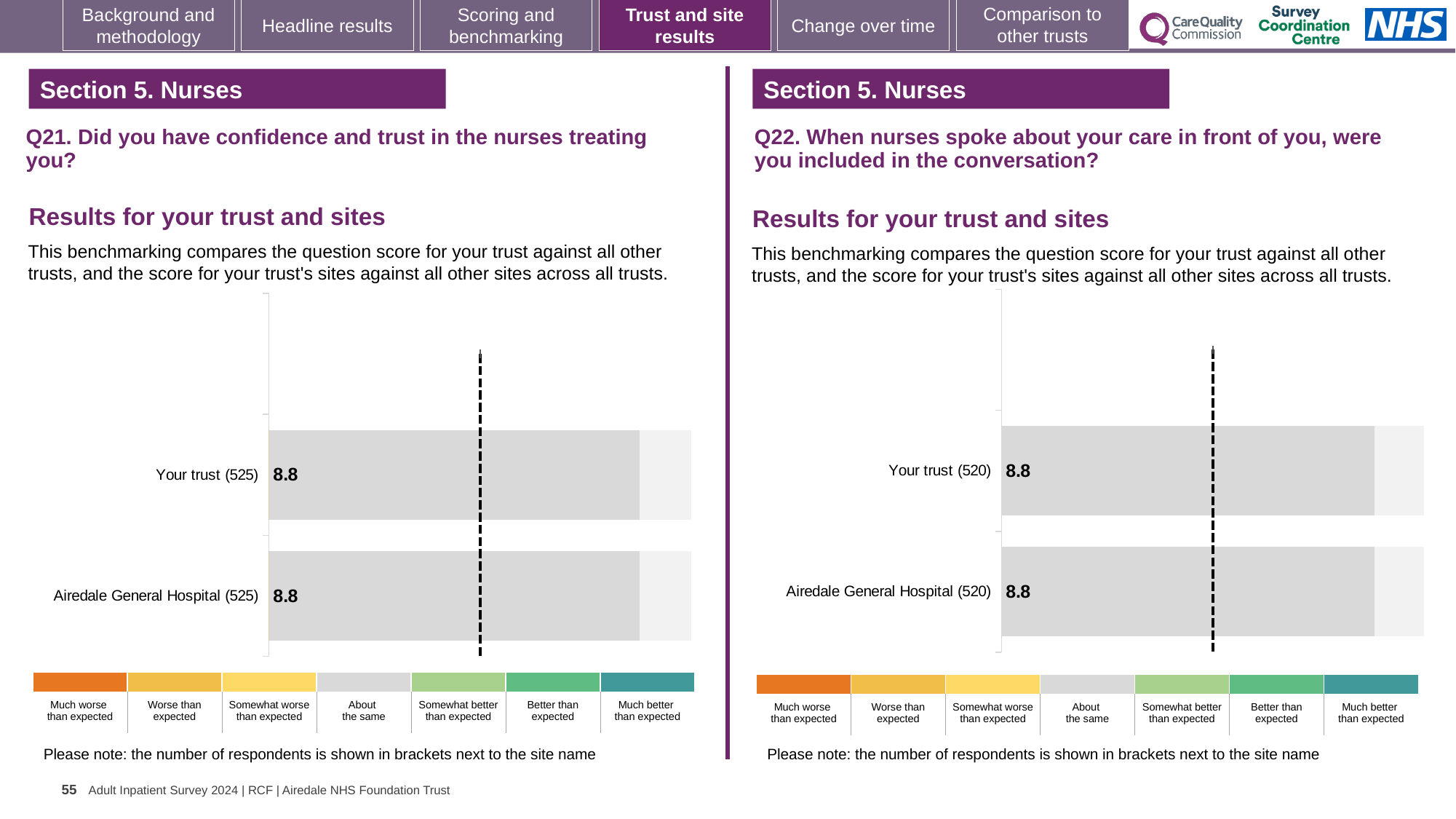
How many bars are plotted on the Q21 chart? 2 On the Q21 chart, how many respondents are shown in brackets next to Your trust? 525 On the Q21 chart, what is the difference between the score for Your trust and the score for Airedale General Hospital? 0 Is the score for Your trust on the Q22 chart greater or less than the score for Your trust on the Q21 chart, or are they equal? Equal On the Q21 chart, what is the score for Your trust? 8.8 On the Q22 chart, how many respondents are shown in brackets next to Airedale General Hospital? 520 On the Q22 chart, what is the score for Your trust? 8.8 On the Q22 chart, what is the difference between the score for Your trust and the score for Airedale General Hospital? 0 On the Q21 chart, what is the score for Airedale General Hospital? 8.8 What kind of chart is the Q21 chart? Bar chart How many bars are plotted on the Q22 chart? 2 On the Q22 chart, what is the score for Airedale General Hospital? 8.8